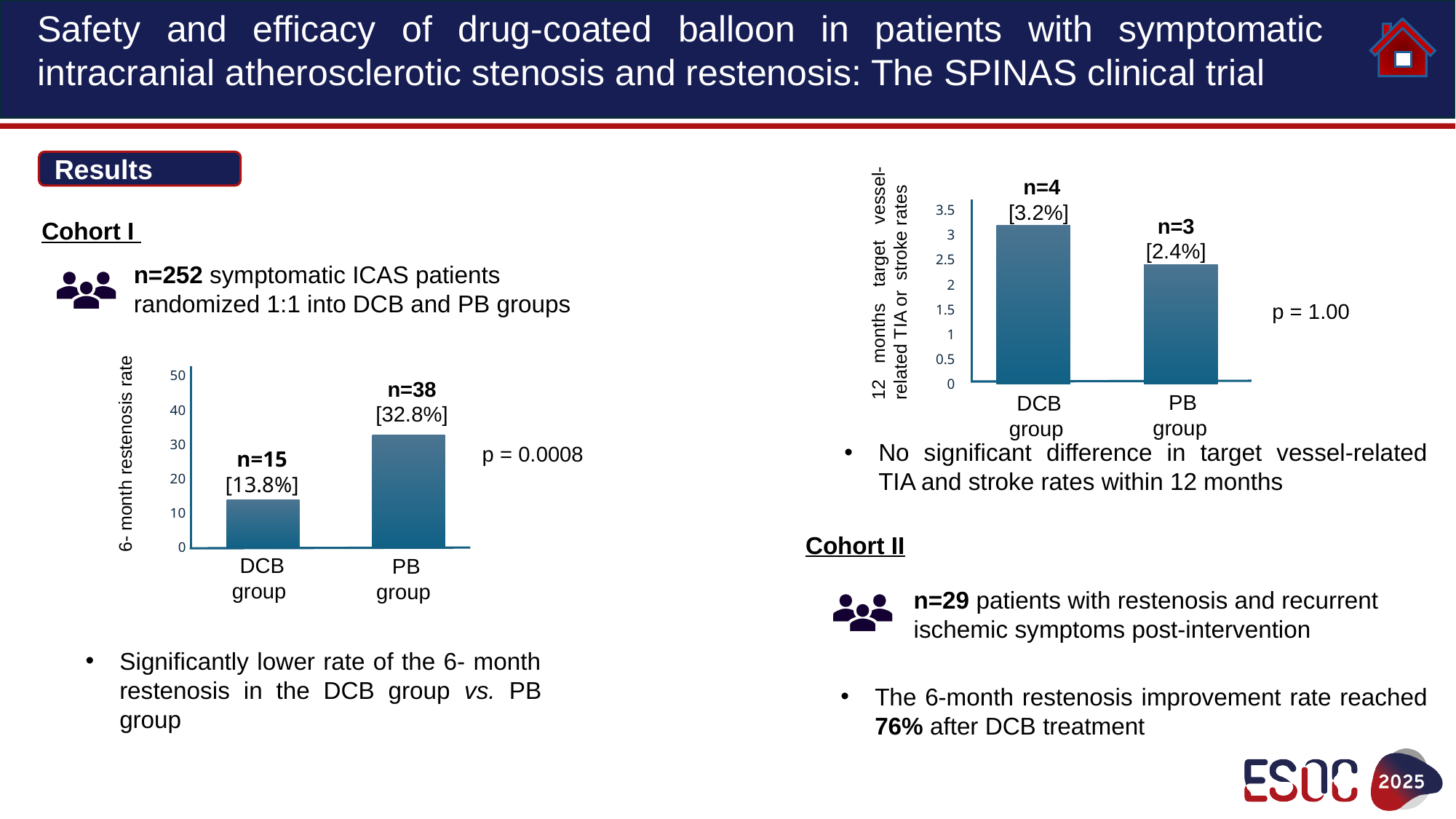
On the right chart (12 months target vessel-related TIA or stroke rates), which group has the lower rate? PB group On the left chart (6-month restenosis rate), what is the restenosis rate for the PB group? 32.8% On the left chart (6-month restenosis rate), what is the restenosis rate for the DCB group? 13.8% On the right chart (12 months target vessel-related TIA or stroke rates), how many categories are plotted? 2 On the right chart (12 months target vessel-related TIA or stroke rates), what is the rate for the DCB group? 3.2% On the right chart (12 months target vessel-related TIA or stroke rates), what is the rate for the PB group? 2.4% On the left chart (6-month restenosis rate), which group has the higher restenosis rate? PB group What kind of chart is the left chart (6-month restenosis rate)? Bar chart On the left chart (6-month restenosis rate), how many patients (n) had restenosis in the PB group? n=38 On the left chart (6-month restenosis rate), is the value for the PB group greater or less than 30? greater On the left chart (6-month restenosis rate), what is the difference in restenosis rate between the PB group and the DCB group? 19.0% What p-value is shown next to the right chart (12 months target vessel-related TIA or stroke rates)? p = 1.00